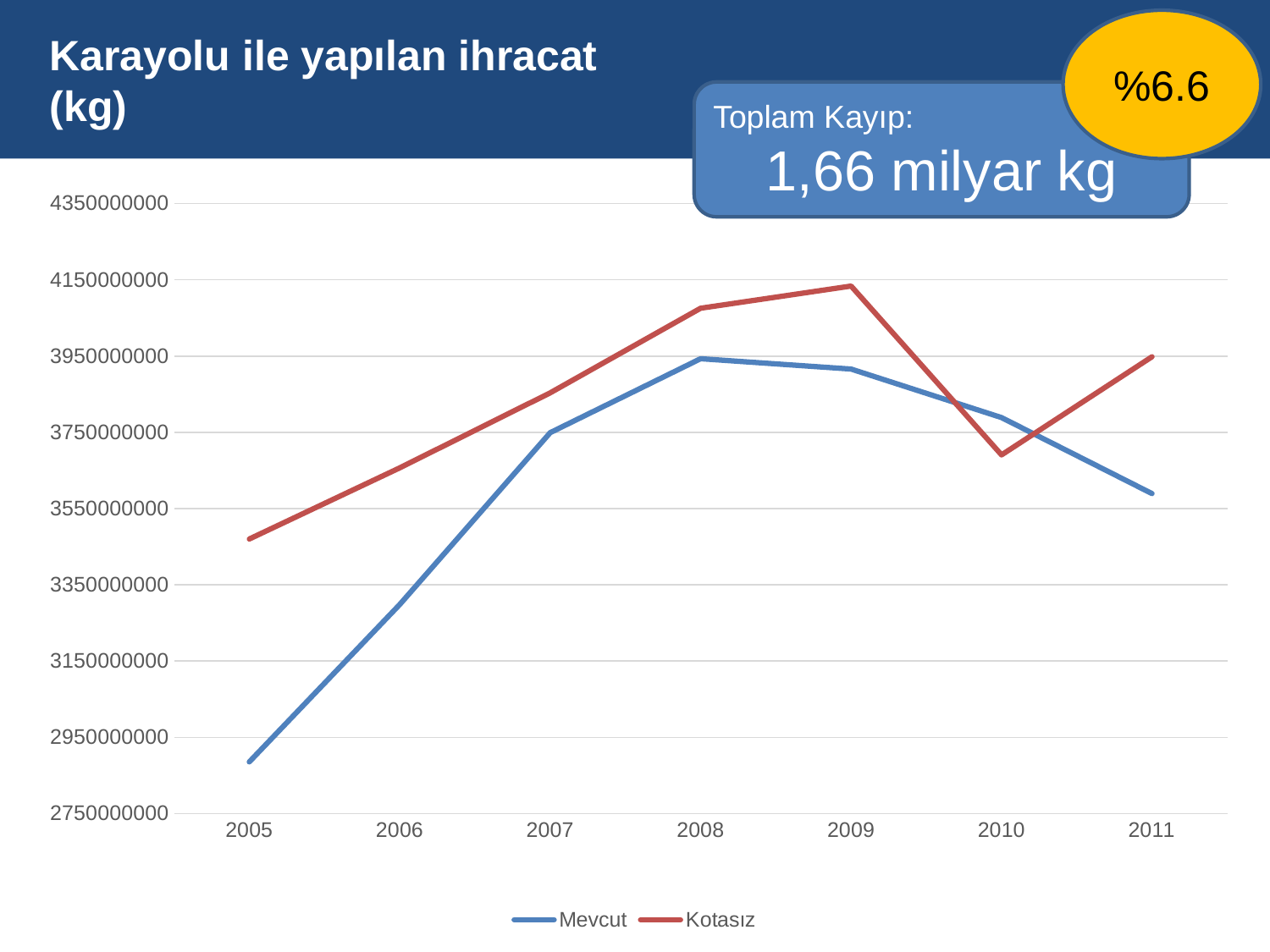
How many years are plotted along the x axis? 7 In 2010, which series has the larger value, Mevcut or Kotasız? Mevcut Is the Mevcut value for 2011 greater or less than 3750000000? less What are the names of the two series in the legend? Mevcut and Kotasız Which year has the highest value for the Kotasız series? 2009 Is the Kotasız value for 2008 greater or less than 3950000000? greater Does the Mevcut series rise or fall from 2008 to 2011? fall What kind of chart is shown on the slide? line chart How many series does the legend list? 2 Is the Mevcut value for 2005 greater or less than 2950000000? less Which year has the lowest value for the Mevcut series? 2005 Which year has the lowest value for the Kotasız series? 2005